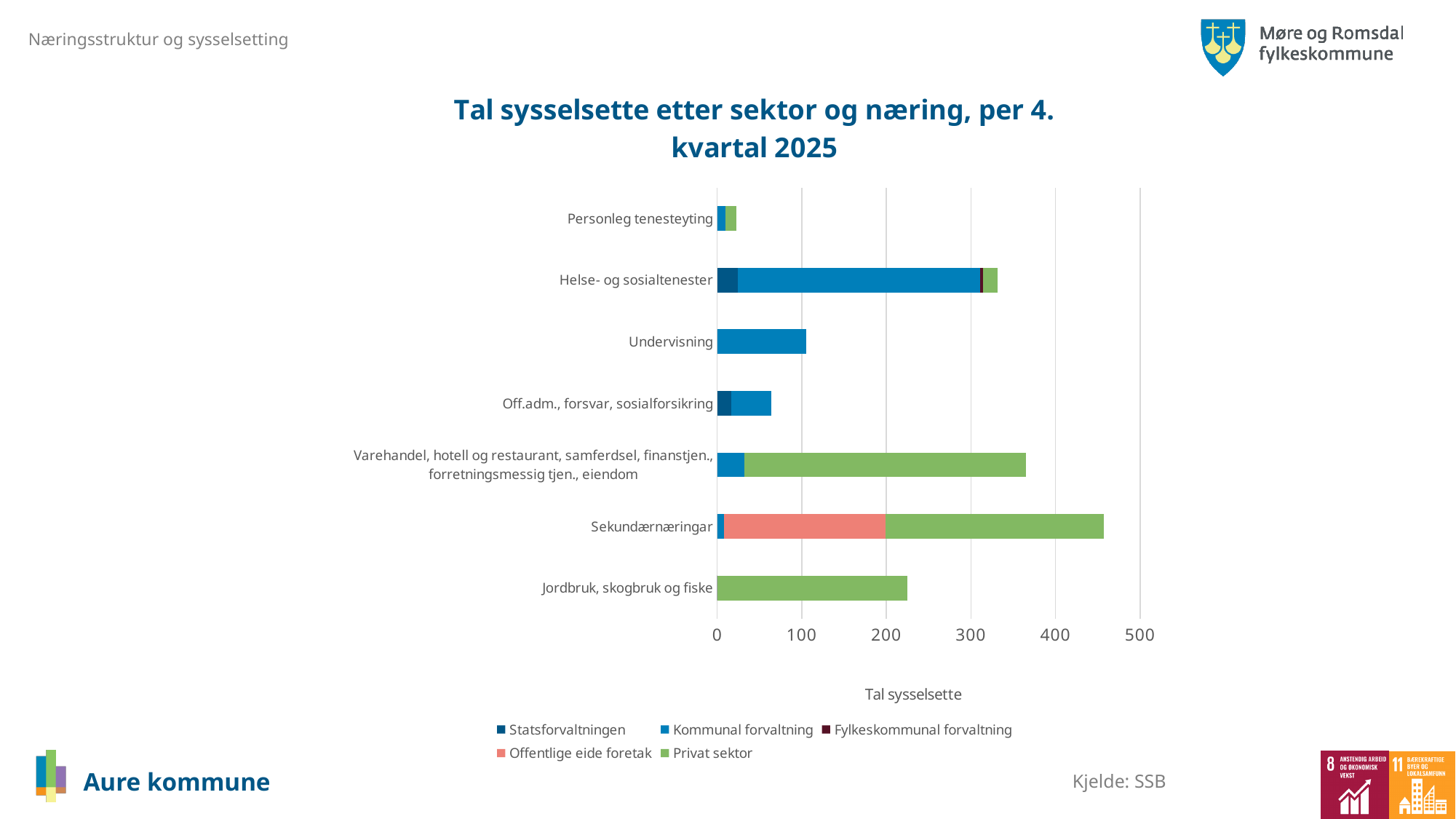
Is the total value for Helse- og sosialtenester greater or less than 300? greater How many series does the legend list? 5 Which category has the shortest total bar? Personleg tenesteyting What is the label on the x axis of the chart? Tal sysselsette How many categories (industries) are shown on the y axis of the chart? 7 What is the title of the chart? Tal sysselsette etter sektor og næring, per 4. kvartal 2025 Is the total value for Jordbruk, skogbruk og fiske greater or less than 200? greater Which category has the longest total bar? Sekundærnæringar Is the total value for Off.adm., forsvar, sosialforsikring greater or less than 100? less What kind of chart is shown on the slide? bar chart Which has the larger total bar: Jordbruk, skogbruk og fiske or Undervisning? Jordbruk, skogbruk og fiske